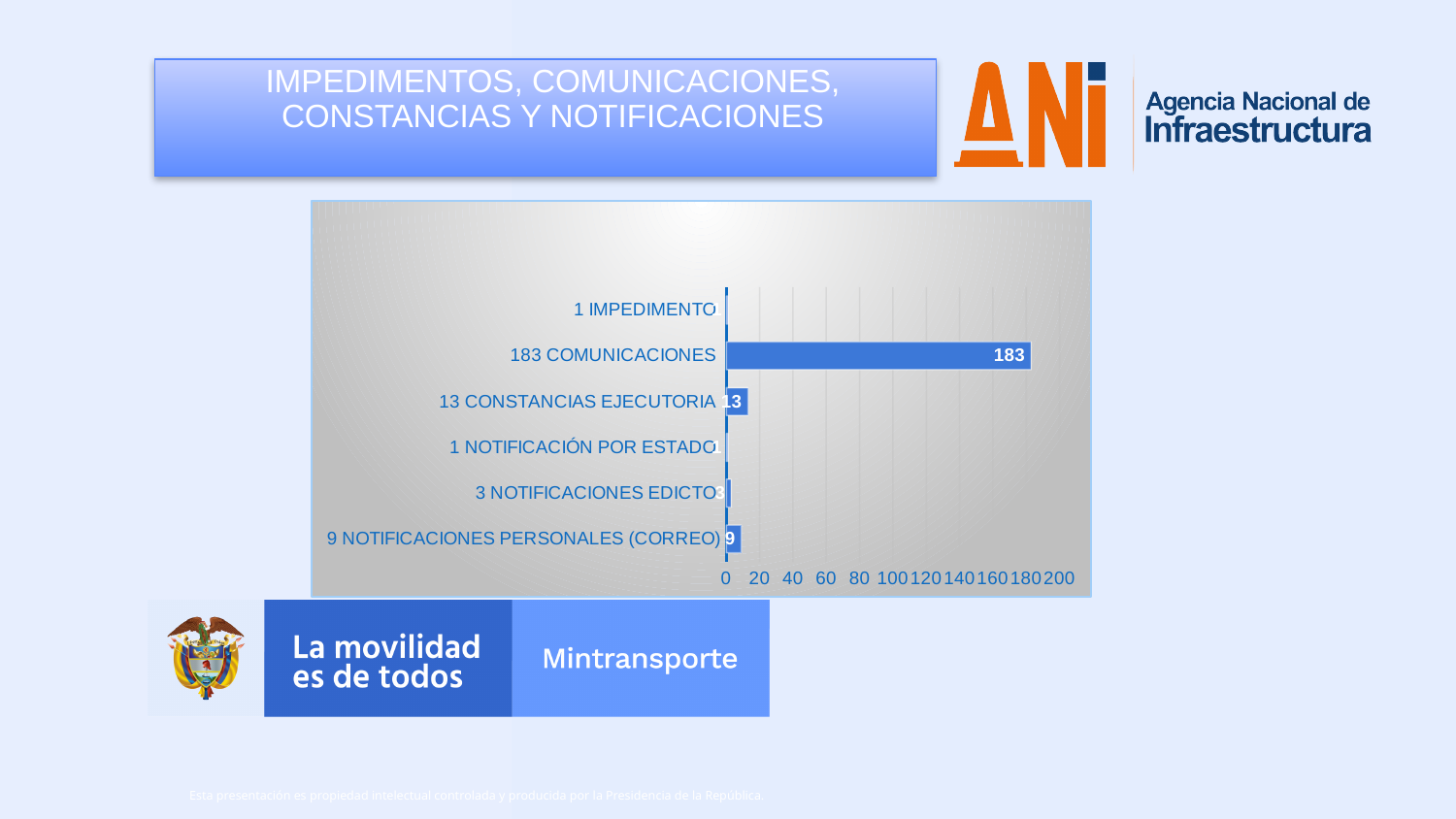
What kind of chart is shown on the slide? bar chart What is the value for NOTIFICACIONES PERSONALES (CORREO)? 9 What is the value for NOTIFICACIONES EDICTO? 3 Is the value for COMUNICACIONES greater or less than 160? greater What is the value for COMUNICACIONES? 183 How many categories are shown in the chart? 6 Which category has the highest value? COMUNICACIONES Which is larger, the value for CONSTANCIAS EJECUTORIA or the value for NOTIFICACIONES PERSONALES (CORREO)? CONSTANCIAS EJECUTORIA What is the value for CONSTANCIAS EJECUTORIA? 13 Is the value for CONSTANCIAS EJECUTORIA greater or less than 20? less What is the title shown in the box at the top left of the slide? IMPEDIMENTOS, COMUNICACIONES, CONSTANCIAS Y NOTIFICACIONES What is the difference between the values for COMUNICACIONES and CONSTANCIAS EJECUTORIA? 170